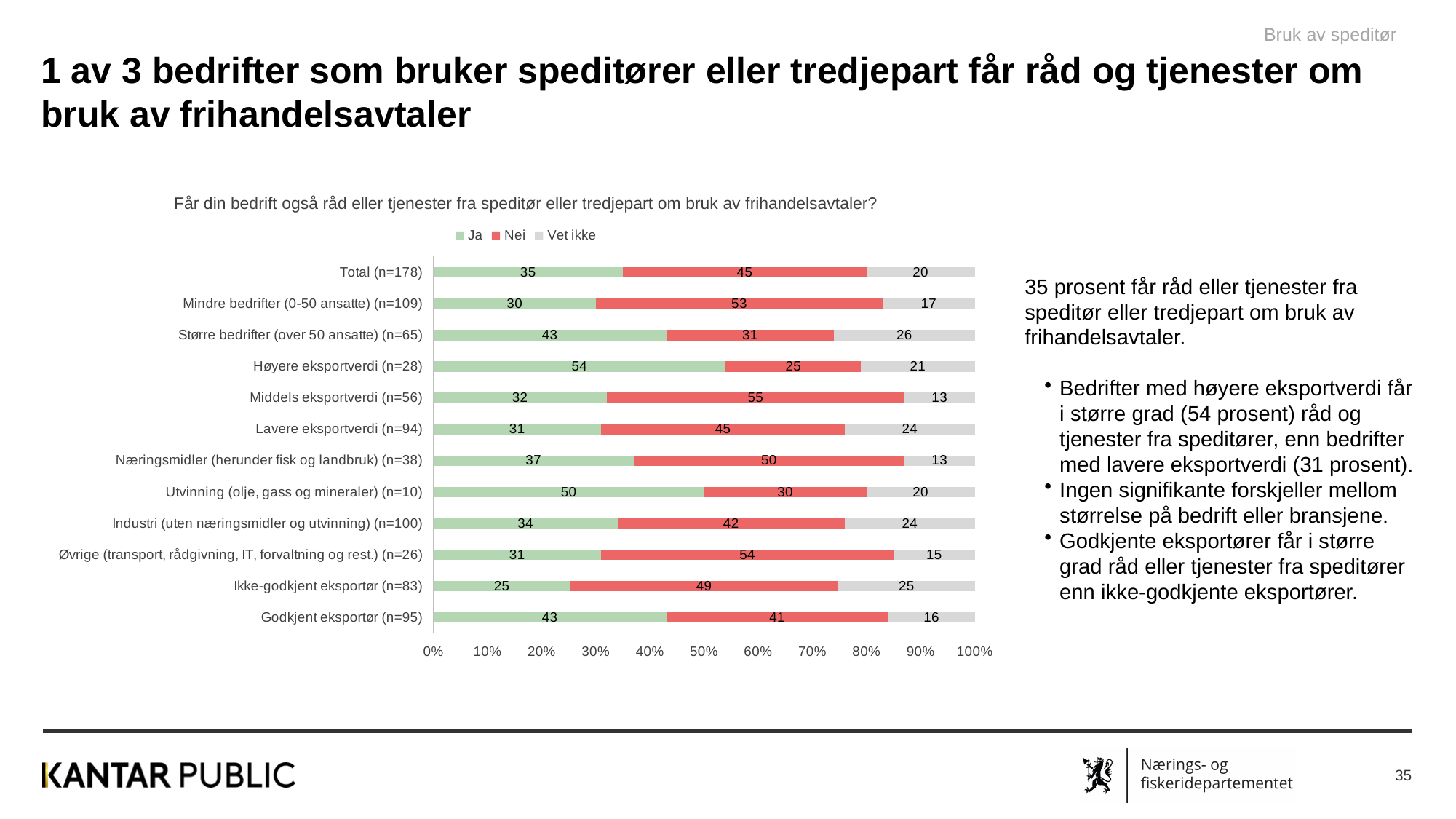
What is the total of the stacked bar for Industri (uten næringsmidler og utvinning) (n=100)? 100 What colour represents the 'Nei' series in the chart? Red Which has a larger 'Nei' value, Utvinning (olje, gass og mineraler) (n=10) or Næringsmidler (herunder fisk og landbruk) (n=38)? Næringsmidler (herunder fisk og landbruk) (n=38) How many series does the legend list? 3 Which category has the highest 'Ja' value? Høyere eksportverdi (n=28) What is the 'Ja' value for Total (n=178)? 35 Which category has the lowest 'Ja' value? Ikke-godkjent eksportør (n=83) How many categories are plotted on the chart? 12 What is the 'Nei' value for Mindre bedrifter (0-50 ansatte) (n=109)? 53 What is the difference between the 'Ja' values for Godkjent eksportør (n=95) and Ikke-godkjent eksportør (n=83)? 18 What is the 'Vet ikke' value for Større bedrifter (over 50 ansatte) (n=65)? 26 What type of chart is shown on the slide? Stacked bar chart